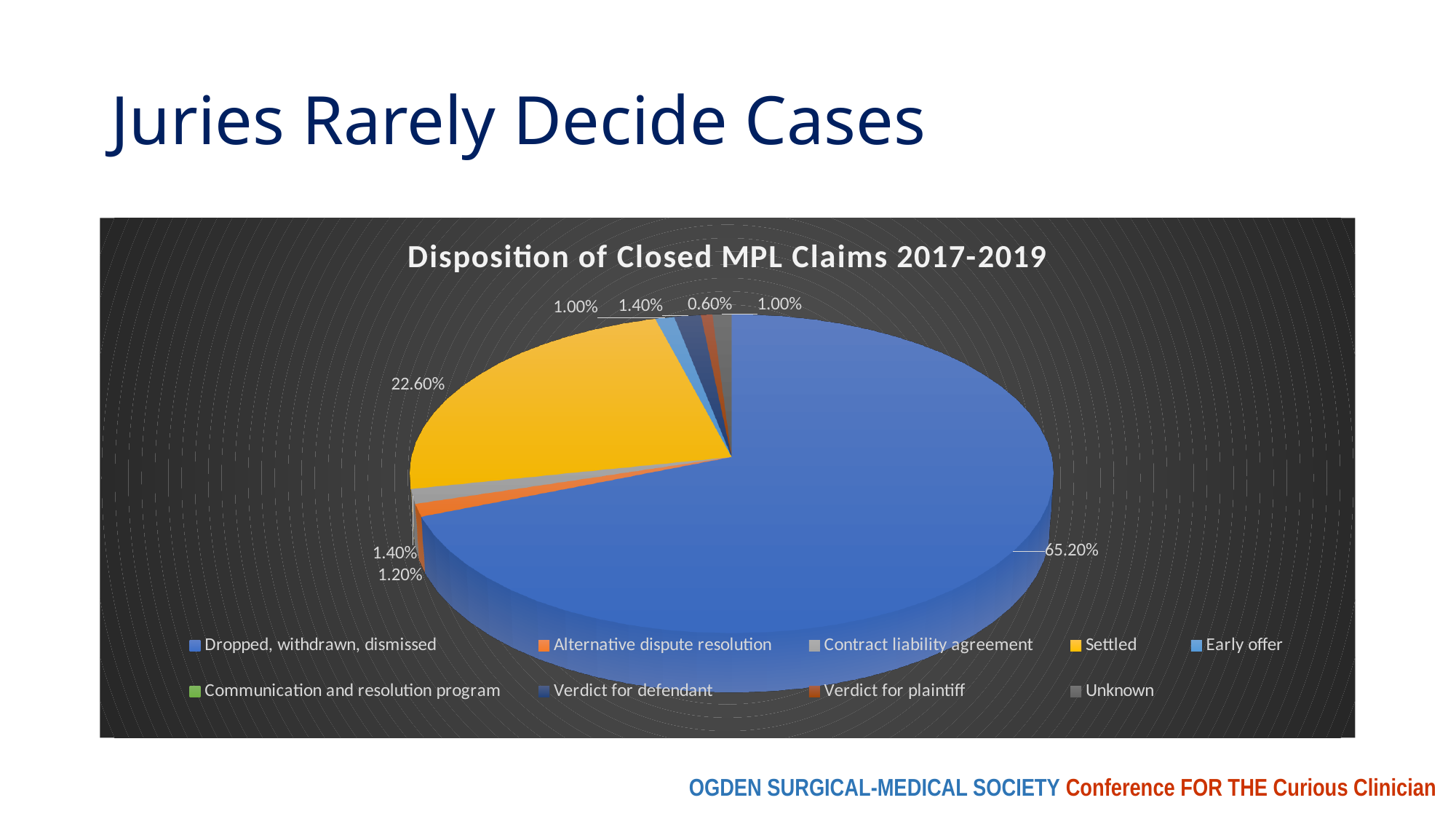
Is the share for Settled greater or less than 50%? less What percentage of closed MPL claims were settled? 22.60% What colour represents the Settled category in the pie chart? Yellow How many categories does the legend list? 9 What type of chart is shown on the slide? Pie chart What is the difference in percentage points between the Dropped, withdrawn, dismissed share and the Settled share? 42.60% What percentage of closed MPL claims were dropped, withdrawn, or dismissed? 65.20% Which is larger: the share for Settled or the share for Dropped, withdrawn, dismissed? Dropped, withdrawn, dismissed Which disposition category has the largest share of the pie? Dropped, withdrawn, dismissed What is the title of the chart? Disposition of Closed MPL Claims 2017-2019 What is the smallest percentage label shown on the pie chart? 0.60%